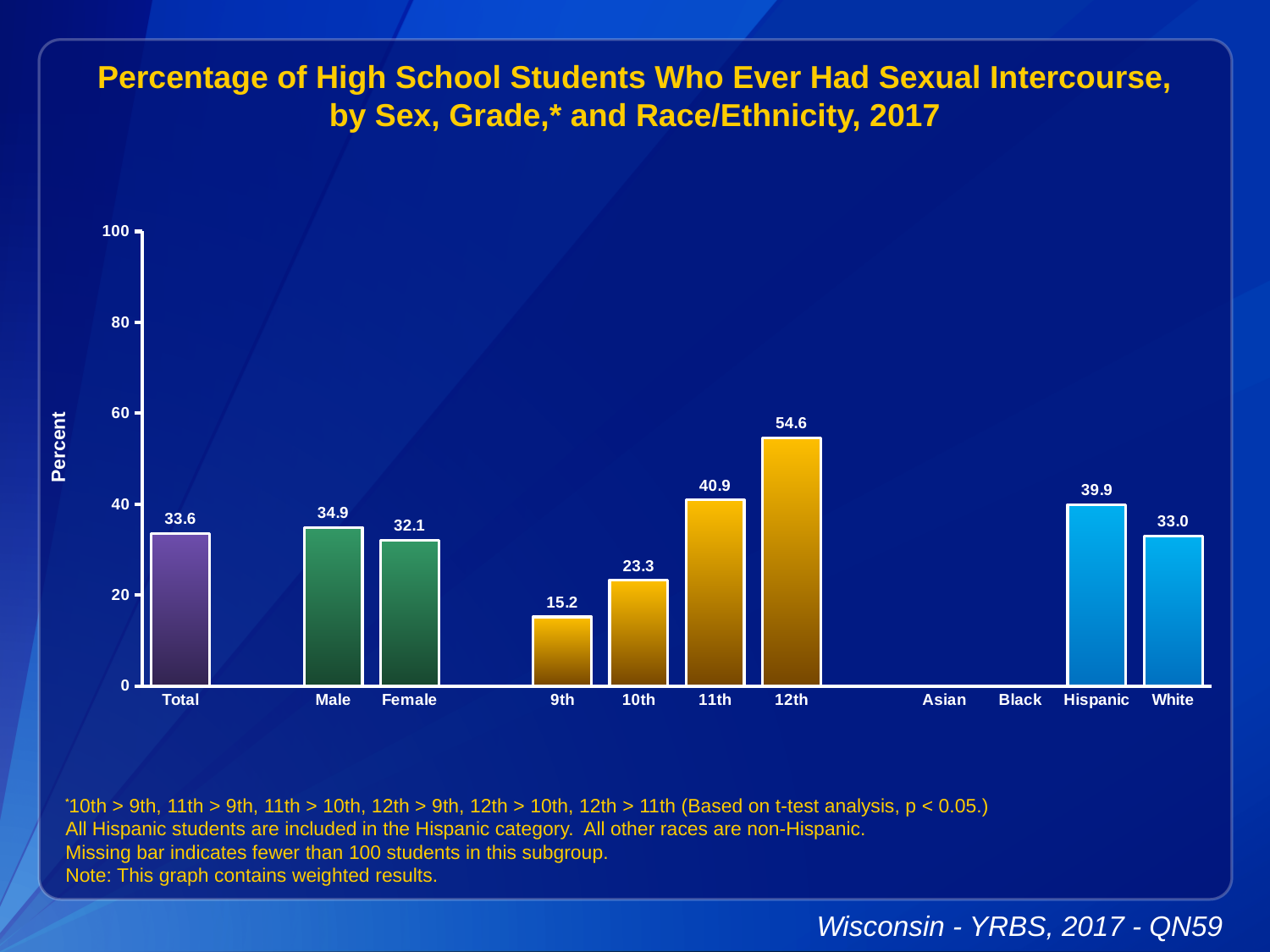
Do the values rise or fall from 9th grade to 12th grade? rise Is the value for 11th grade greater or less than 40? greater Which category has the highest value? 12th What is the value for Hispanic students? 39.9 What is the value for Total? 33.6 Which category with a plotted bar has the lowest value? 9th What is the difference between the 12th and 9th grade values? 39.4 How many categories are labeled on the x axis? 11 Which is larger, the value for Hispanic or the value for White? Hispanic What is the value for 12th grade? 54.6 What kind of chart is shown? bar chart What is the difference between the Male and Female values? 2.8